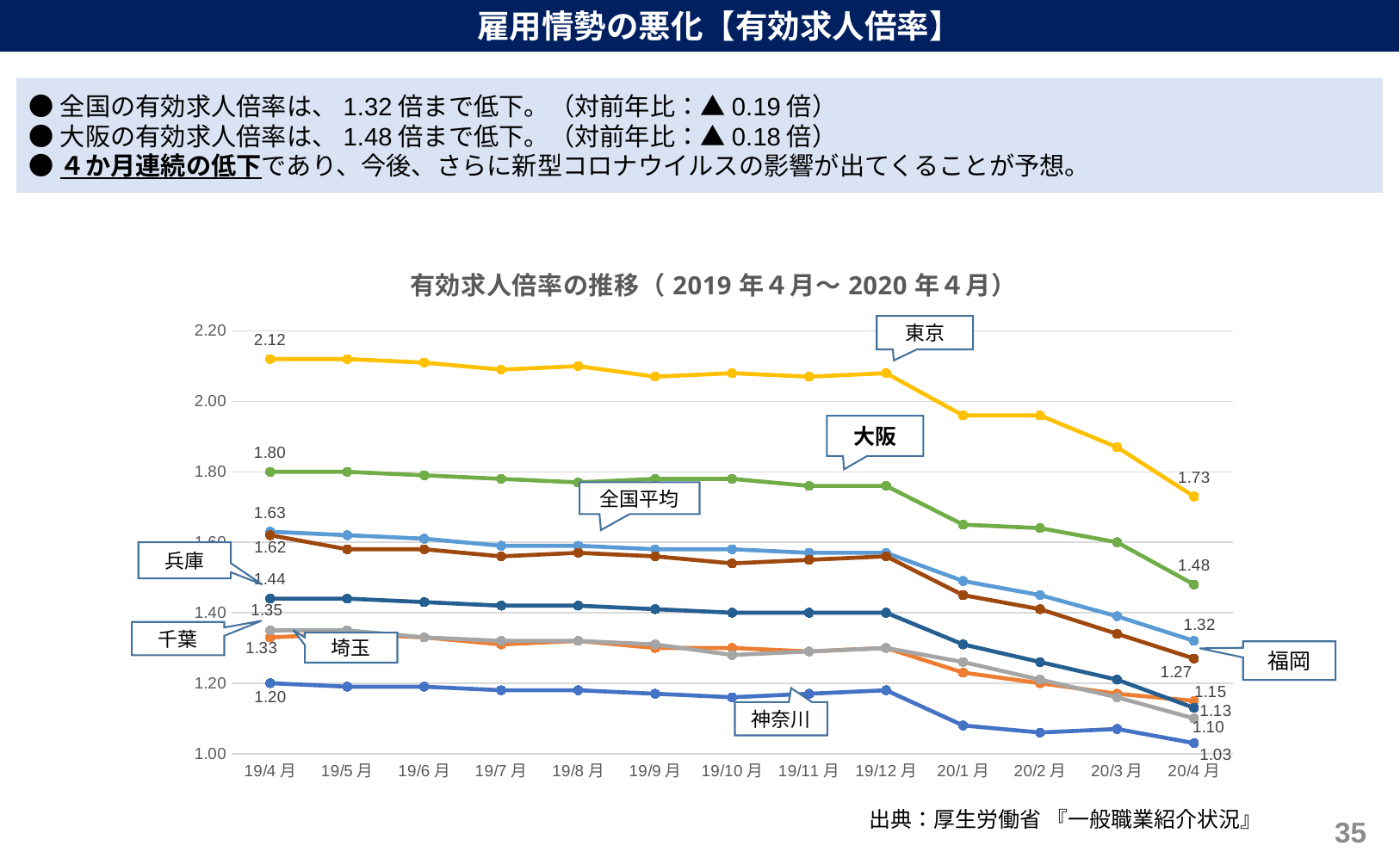
What is the value for 大阪 in 20/4月? 1.48 Which series has the highest value in 20/4月? 東京 By how much did the value for 大阪 fall from 19/4月 (1.80) to 20/4月 (1.48)? 0.32 Which series has the lowest value in 20/4月? 神奈川 Is the value for 東京 in 20/1月 greater or less than 2.00? less What kind of chart is shown on the slide? line chart What is the value for 全国平均 in 19/4月? 1.63 What is the value for 神奈川 in 20/4月? 1.03 What is the value for 東京 in 20/4月? 1.73 How many months are shown on the x axis? 13 What is the value for 福岡 in 20/4月? 1.27 By how much did the value for 東京 fall from 19/4月 (2.12) to 20/4月 (1.73)? 0.39